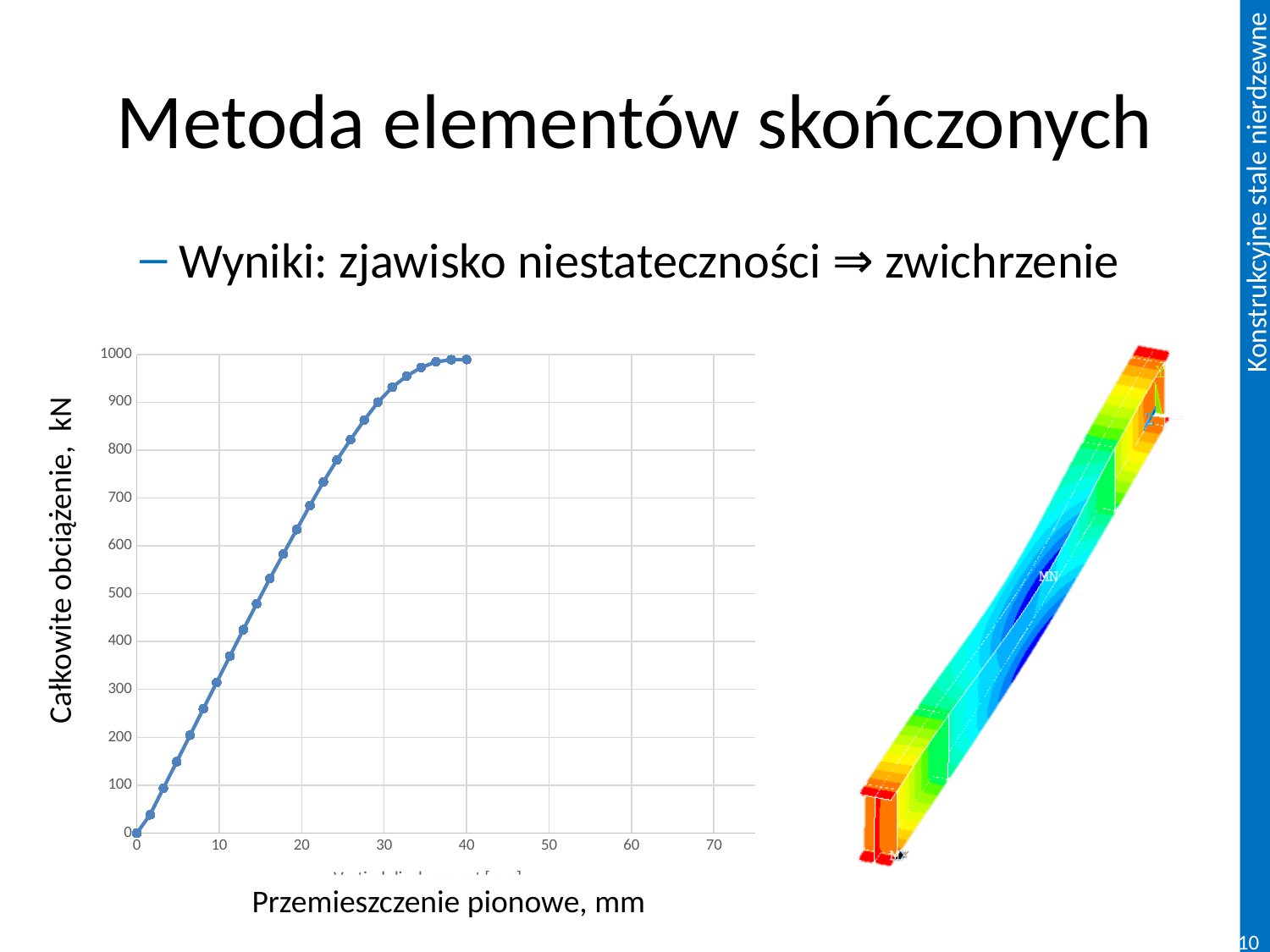
Is the total load at a vertical displacement of 15 mm greater or less than 400 kN? greater What is the total load at a vertical displacement of 0 mm? 0 What is the label of the horizontal axis of the chart? Przemieszczenie pionowe, mm What is the label of the vertical axis of the chart? Całkowite obciążenie, kN Is the largest vertical displacement plotted on the curve greater or less than 50 mm? less Is the highest total load reached on the curve greater or less than 900 kN? greater Does the total load rise or fall as the vertical displacement increases along the x axis? rise What kind of chart is shown on the slide? line chart